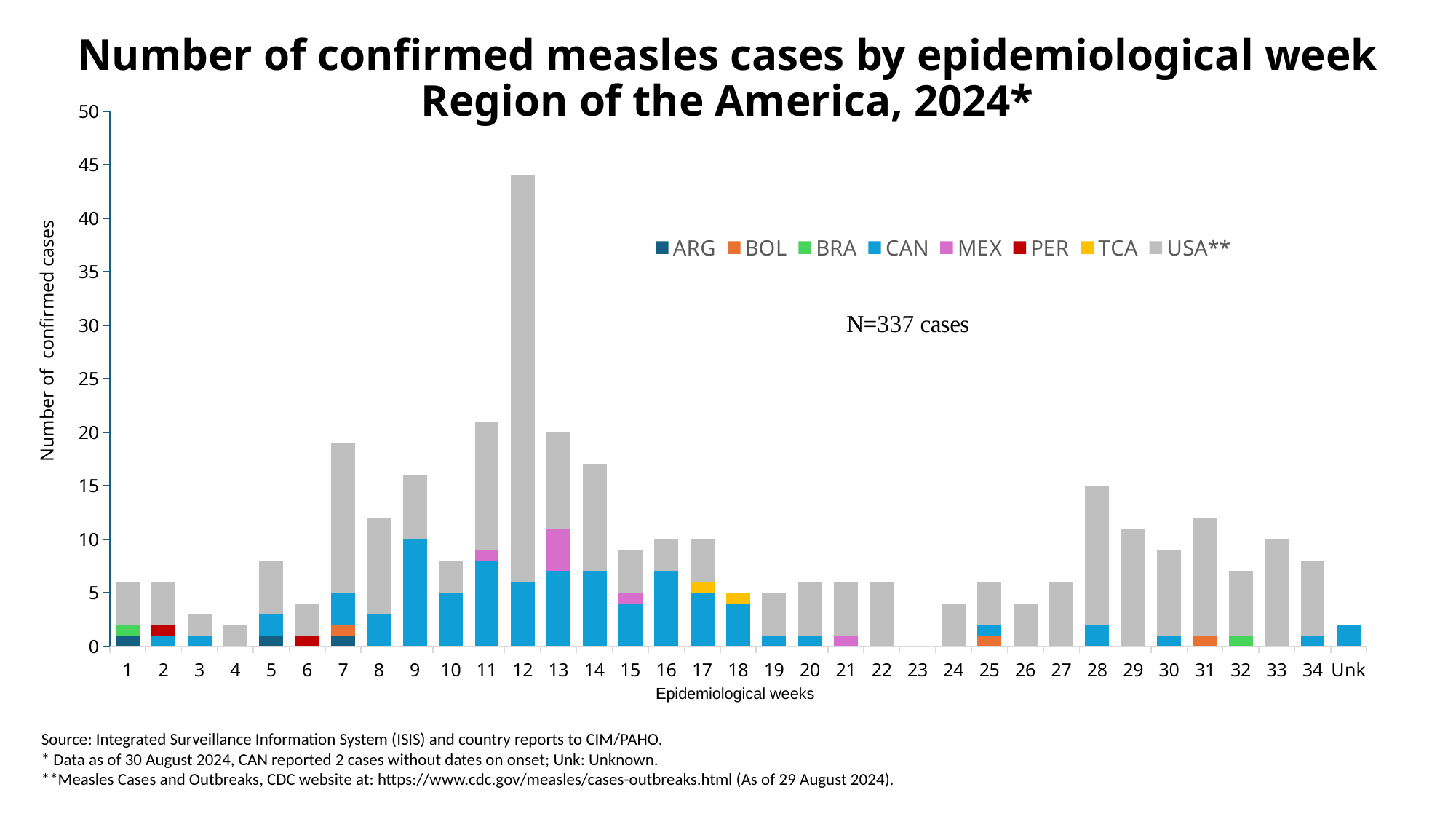
Which week has more confirmed cases, week 11 or week 12? Week 12 Which series is shown in grey in the legend? USA** Is the total number of confirmed cases in week 4 greater or less than 5? less Which epidemiological week has the highest number of confirmed cases? 12 Is the total number of confirmed cases in week 12 greater or less than 40? greater What total number of cases (N) is stated on the chart? N=337 cases What kind of chart is shown on the slide? Stacked bar chart How many series does the legend list? 8 Is the total number of confirmed cases in week 7 greater or less than 15? greater How many categories are shown along the x axis (epidemiological weeks including Unk)? 35 Do the total confirmed cases rise or fall from week 12 to week 19? Fall Which week has more confirmed cases, week 28 or week 29? Week 28